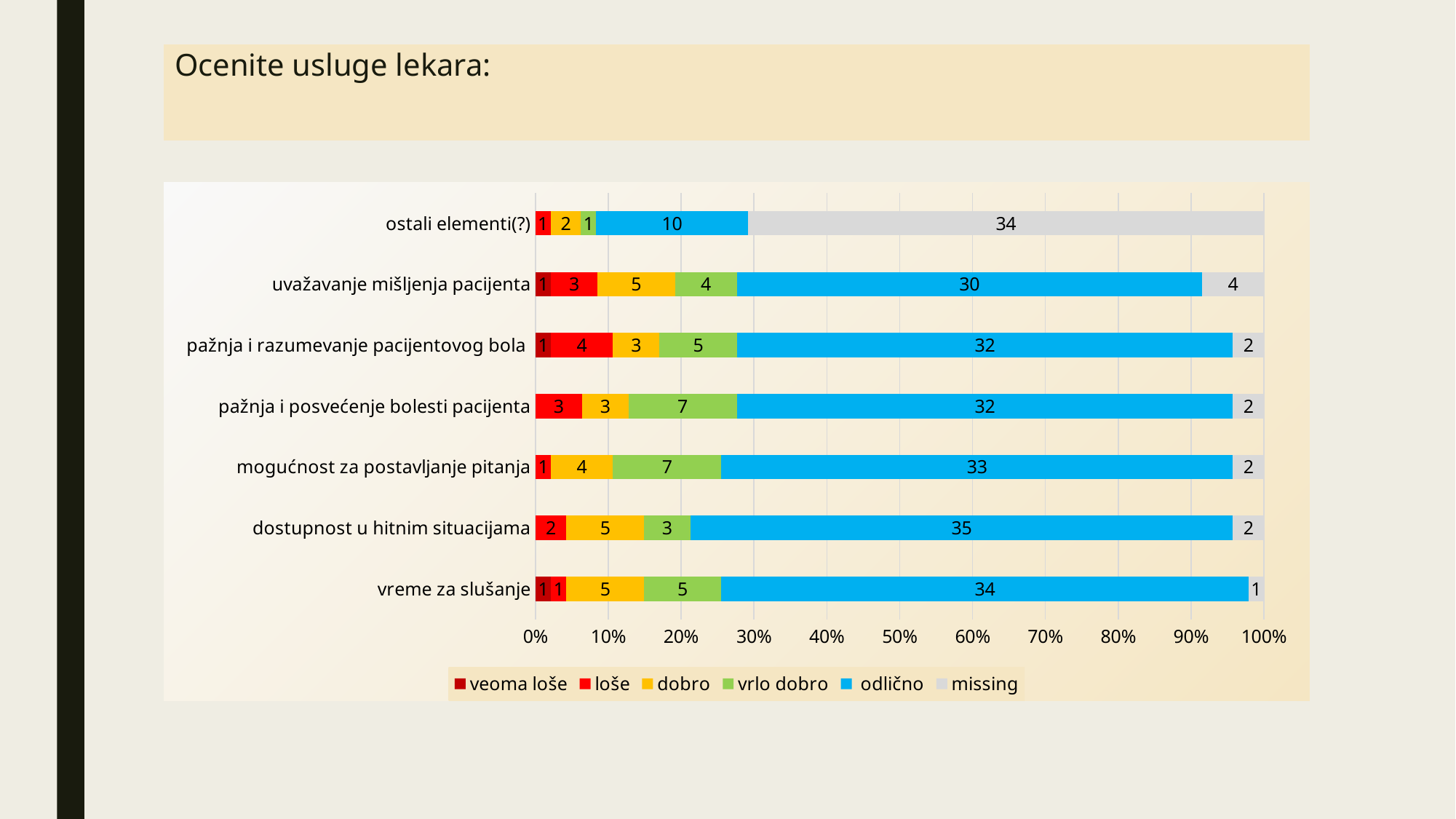
Which is larger: the 'dobro' value for 'uvažavanje mišljenja pacijenta' or the 'dobro' value for 'pažnja i razumevanje pacijentovog bola'? uvažavanje mišljenja pacijenta What is the title of the chart? Ocenite usluge lekara: What is the 'vrlo dobro' value for 'mogućnost za postavljanje pitanja'? 7 What is the 'odlično' value for 'dostupnost u hitnim situacijama'? 35 What is the total of the labelled values in the 'vreme za slušanje' bar? 47 What is the difference between the 'odlično' values for 'dostupnost u hitnim situacijama' and 'uvažavanje mišljenja pacijenta'? 5 How many series does the legend list? 6 Which category has the lowest 'odlično' value? ostali elementi(?) What kind of chart is shown on the slide? stacked bar chart What is the 'missing' value for 'ostali elementi(?)'? 34 How many categories are plotted on the chart? 7 Which category has the highest 'odlično' value? dostupnost u hitnim situacijama